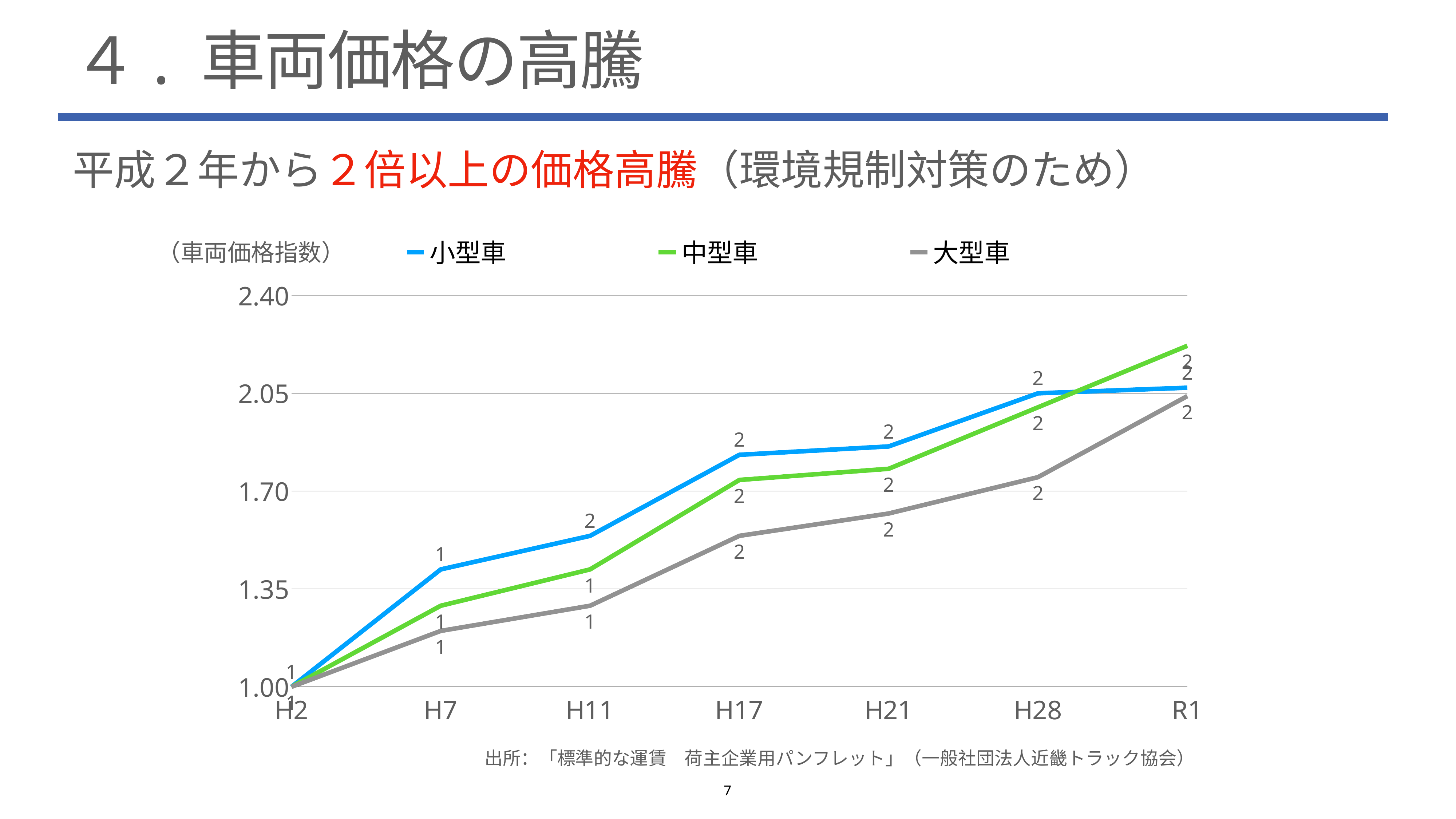
Is the value for 小型車 at H17 greater or less than 1.70? greater Do the values for 大型車 rise or fall from H2 to R1? rise What is the value of 小型車 at H2? 1 Which series has the lowest value at H28? 大型車 Which series has the highest value at H28? 小型車 Is the value for 大型車 at H21 greater or less than 1.70? less How many series does the legend list? 3 Is the value for 中型車 at H7 greater or less than 1.35? less Which series has the highest value at R1? 中型車 How many points are plotted along the x axis for each series? 7 What kind of chart is shown on the slide? line chart What colour is the line for 中型車? green